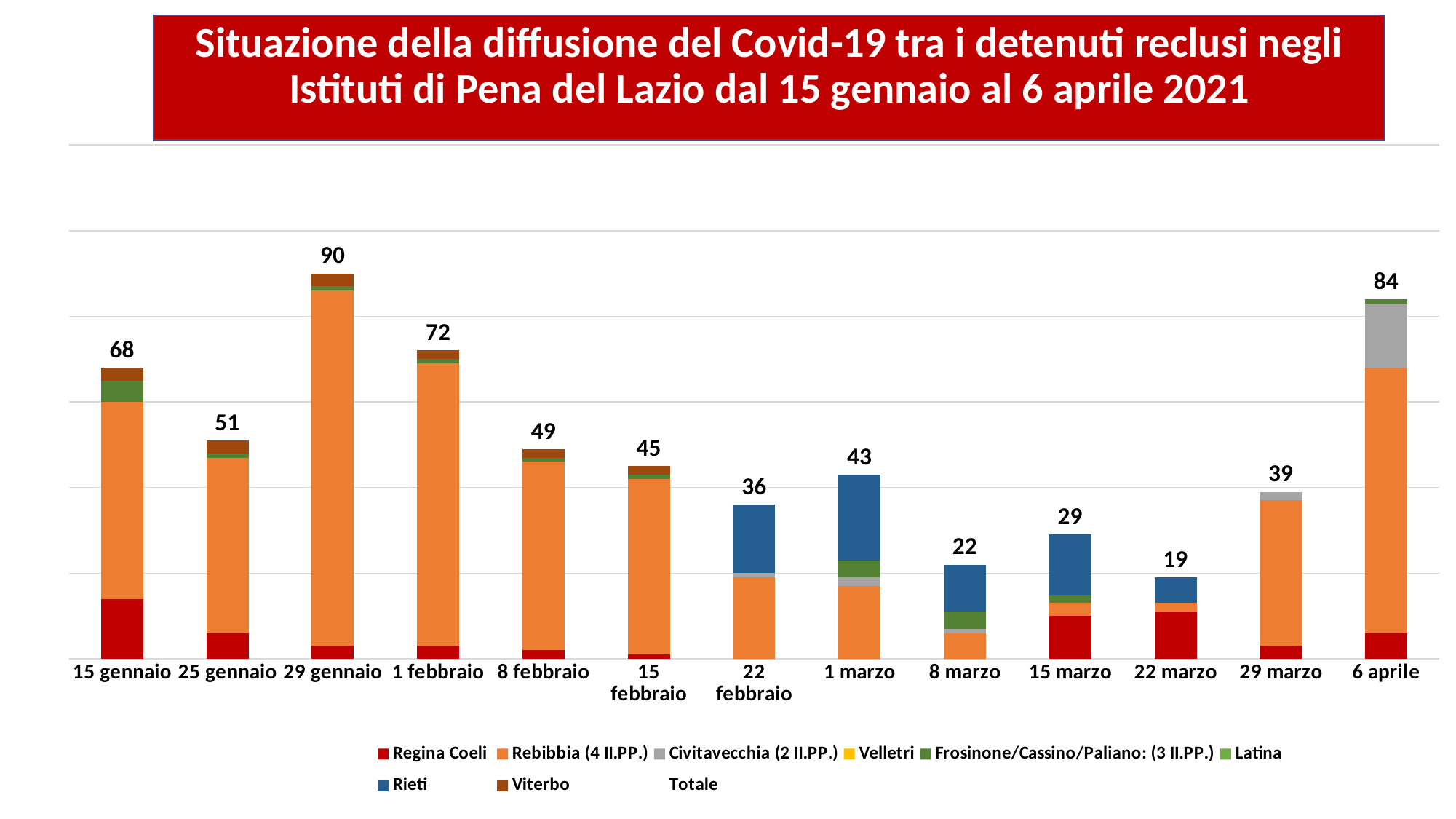
What kind of chart is shown on the slide? Stacked bar chart What is the total value shown for 22 marzo? 19 What is the difference between the totals for 29 gennaio and 6 aprile? 6 Which legend entry is shown in blue? Rieti What is the total value shown for 29 gennaio? 90 What is the total value shown for 6 aprile? 84 How many dates are shown on the x axis? 13 What is the difference between the totals for 15 gennaio and 25 gennaio? 17 Which total is larger, 1 marzo or 22 febbraio? 1 marzo How many entries does the legend list? 9 Which date has the lowest total? 22 marzo Which date has the highest total? 29 gennaio